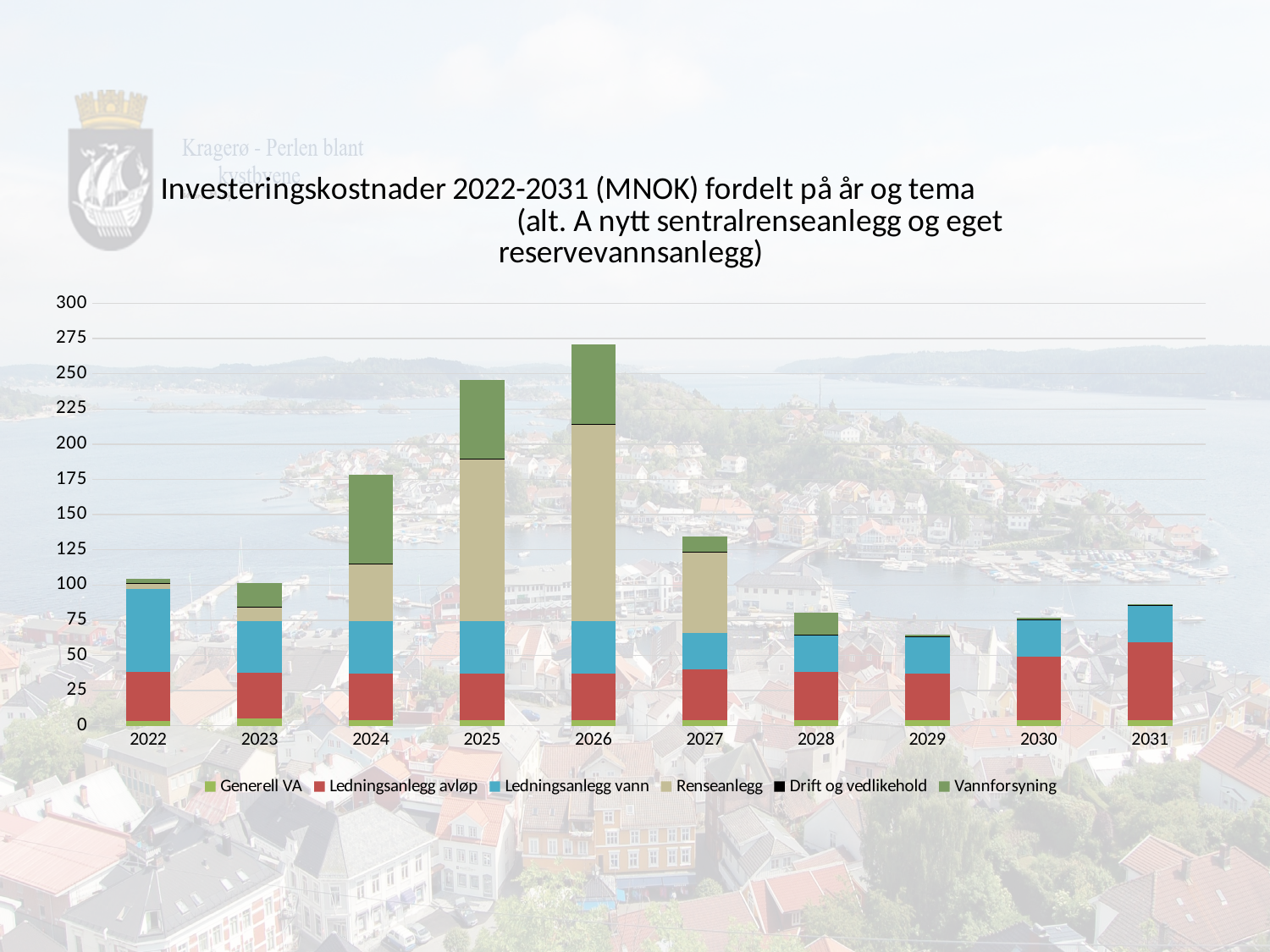
Is the total value for 2025 greater or less than 225? greater How many series does the legend list? 6 Is the total value for 2024 greater or less than 150? greater How many years are shown on the x axis of the chart? 10 Which year has the highest total investment cost? 2026 Do the total values rise or fall from 2026 to 2029? fall Is the total value for 2029 greater or less than 75? less Which series in the legend is shown in dark green? Vannforsyning Which year has the larger total, 2025 or 2027? 2025 Which year has the lowest total investment cost? 2029 What kind of chart is shown on the slide? Stacked bar chart